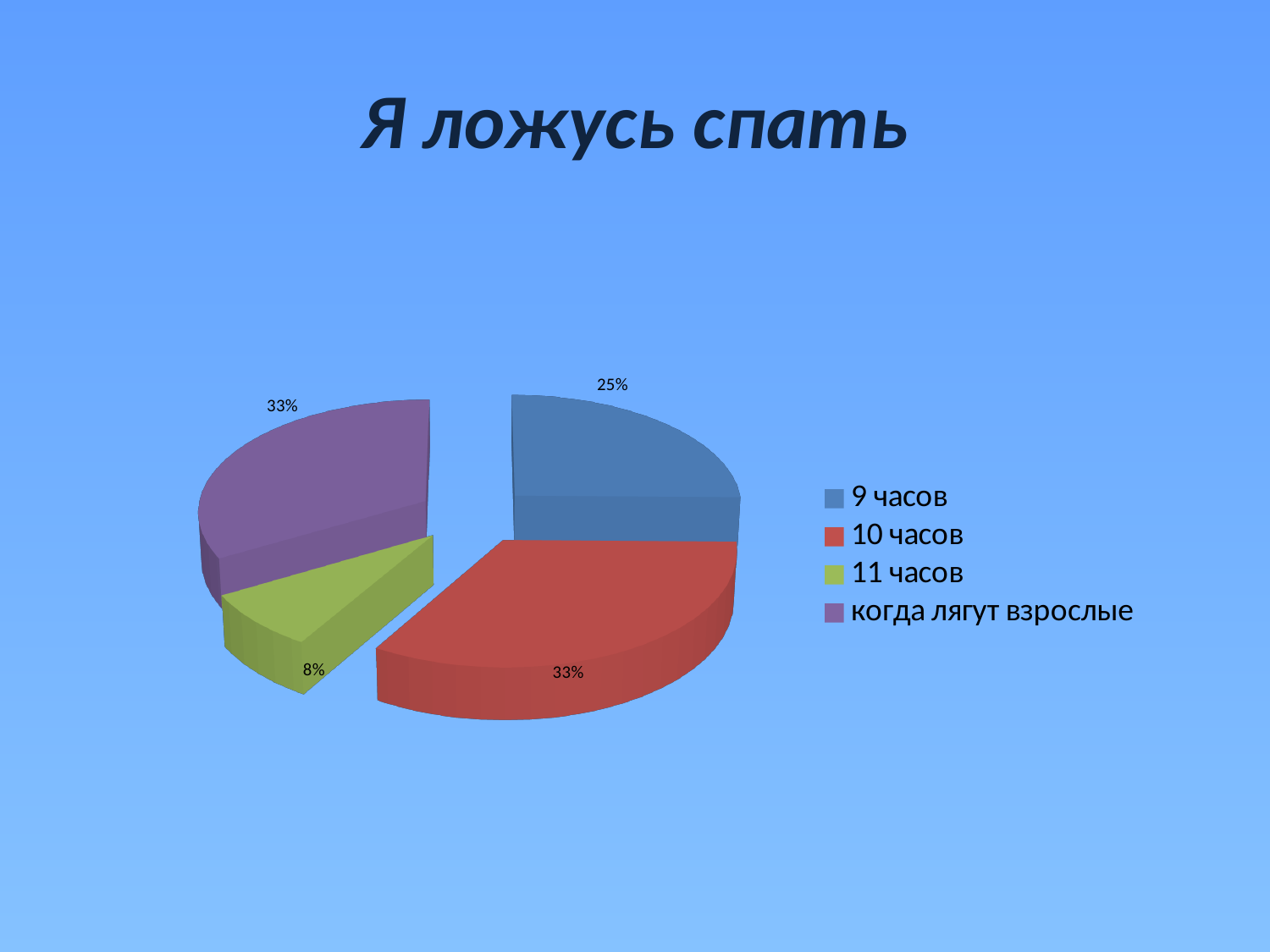
How many slices does the pie chart have? 4 What is the difference in percentage points between the "9 часов" slice and the "11 часов" slice? 17 What is the difference in percentage points between the "10 часов" slice and the "11 часов" slice? 25 Which category has the smallest slice of the pie? 11 часов Which is larger, the slice for "9 часов" or the slice for "11 часов"? 9 часов What share of the pie does the "10 часов" slice represent? 33% What share of the pie does the "9 часов" slice represent? 25% What share of the pie does the "когда лягут взрослые" slice represent? 33% What is the title of the chart on the slide? Я ложусь спать What type of chart is shown on the slide? Pie chart Which is larger, the slice for "10 часов" or the slice for "9 часов"? 10 часов